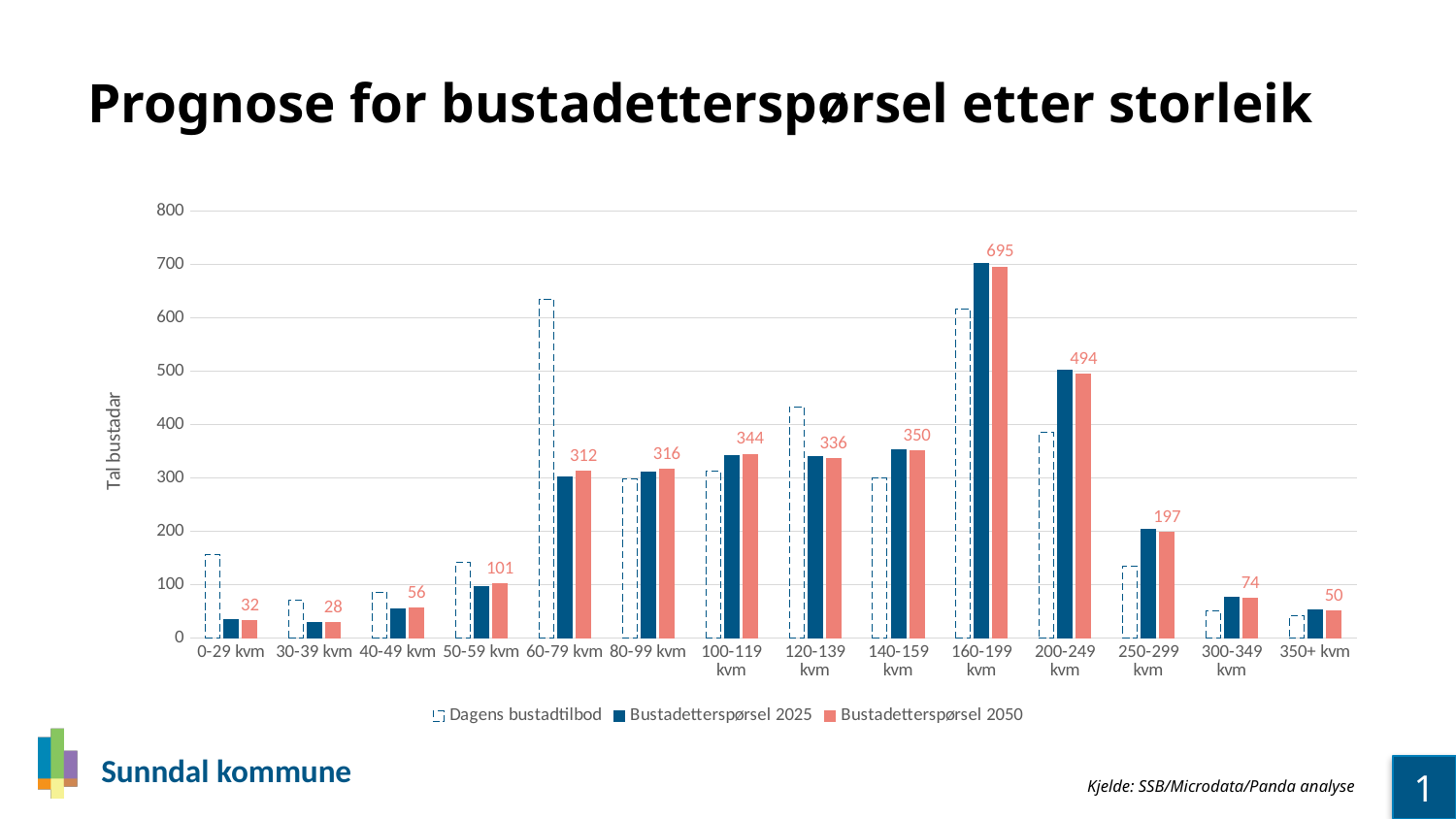
How many series does the legend list? 3 Is the Dagens bustadtilbod value for 60-79 kvm greater or less than 600? greater What is the difference between the Bustadetterspørsel 2050 values for 160-199 kvm and 200-249 kvm? 201 Which is larger: the Bustadetterspørsel 2050 value for 100-119 kvm or for 120-139 kvm? 100-119 kvm Is the Bustadetterspørsel 2025 value for 200-249 kvm greater or less than 400? greater What is the Bustadetterspørsel 2050 value for 250-299 kvm? 197 What is the Bustadetterspørsel 2050 value for 50-59 kvm? 101 What type of chart is shown on the slide? Bar chart What is the Bustadetterspørsel 2050 value for 160-199 kvm? 695 Which size category has the highest Bustadetterspørsel 2050 value? 160-199 kvm Which size category has the lowest Bustadetterspørsel 2050 value? 30-39 kvm How many size categories are shown on the x axis? 14